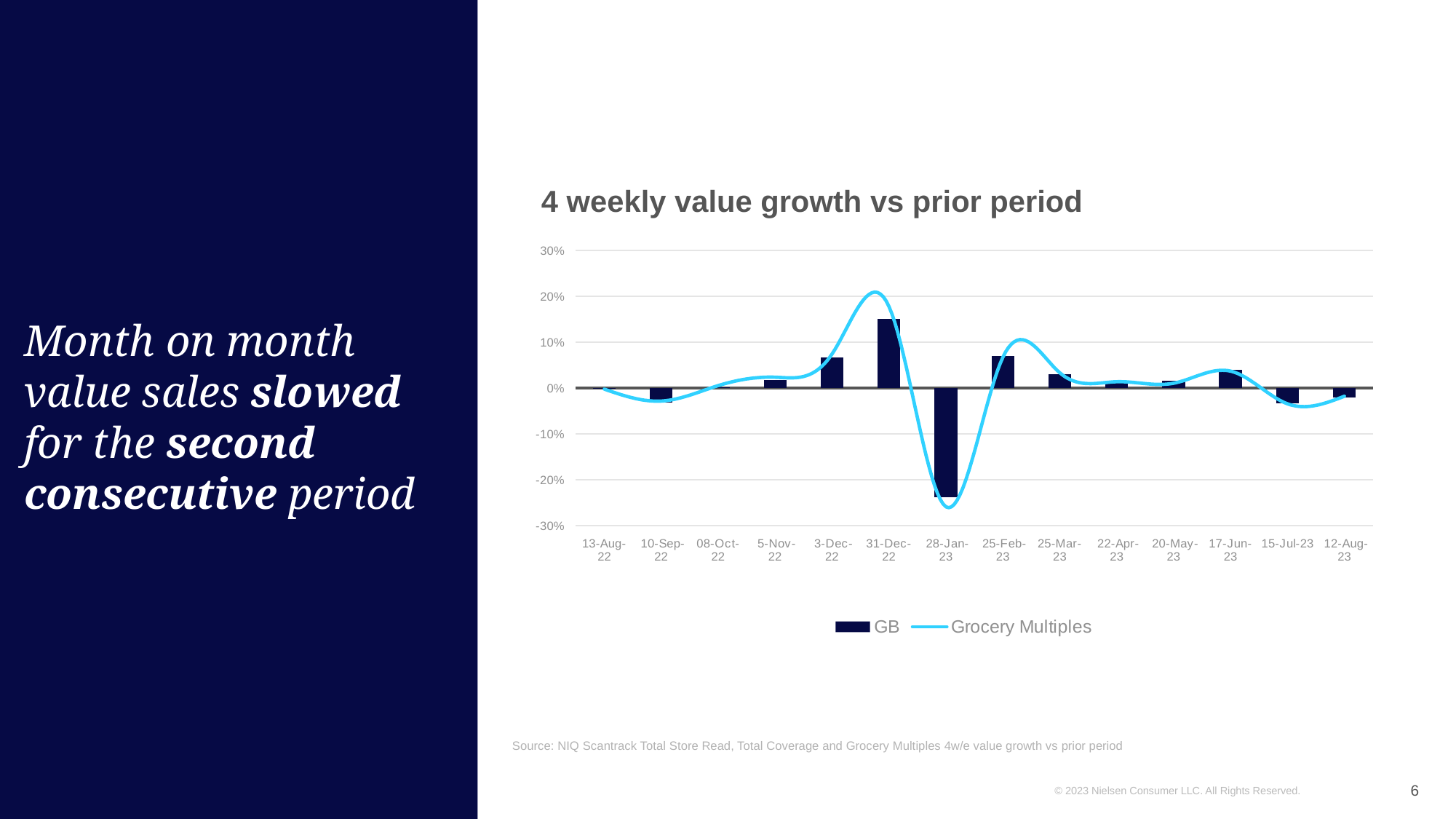
How many periods are shown along the x axis? 14 Does the GB value rise or fall from 31-Dec-22 to 28-Jan-23? fall In which period is the GB bar highest? 31-Dec-22 Is the Grocery Multiples value for 28-Jan-23 greater or less than -20%? less What is the title of the chart? 4 weekly value growth vs prior period Which has the larger GB value, 3-Dec-22 or 25-Mar-23? 3-Dec-22 What kind of chart is shown on the slide? A combined bar and line chart Is the GB value for 31-Dec-22 greater or less than 10%? greater How many series does the legend list? 2 Is the GB value for 28-Jan-23 greater or less than -20%? less In which period is the GB bar lowest? 28-Jan-23